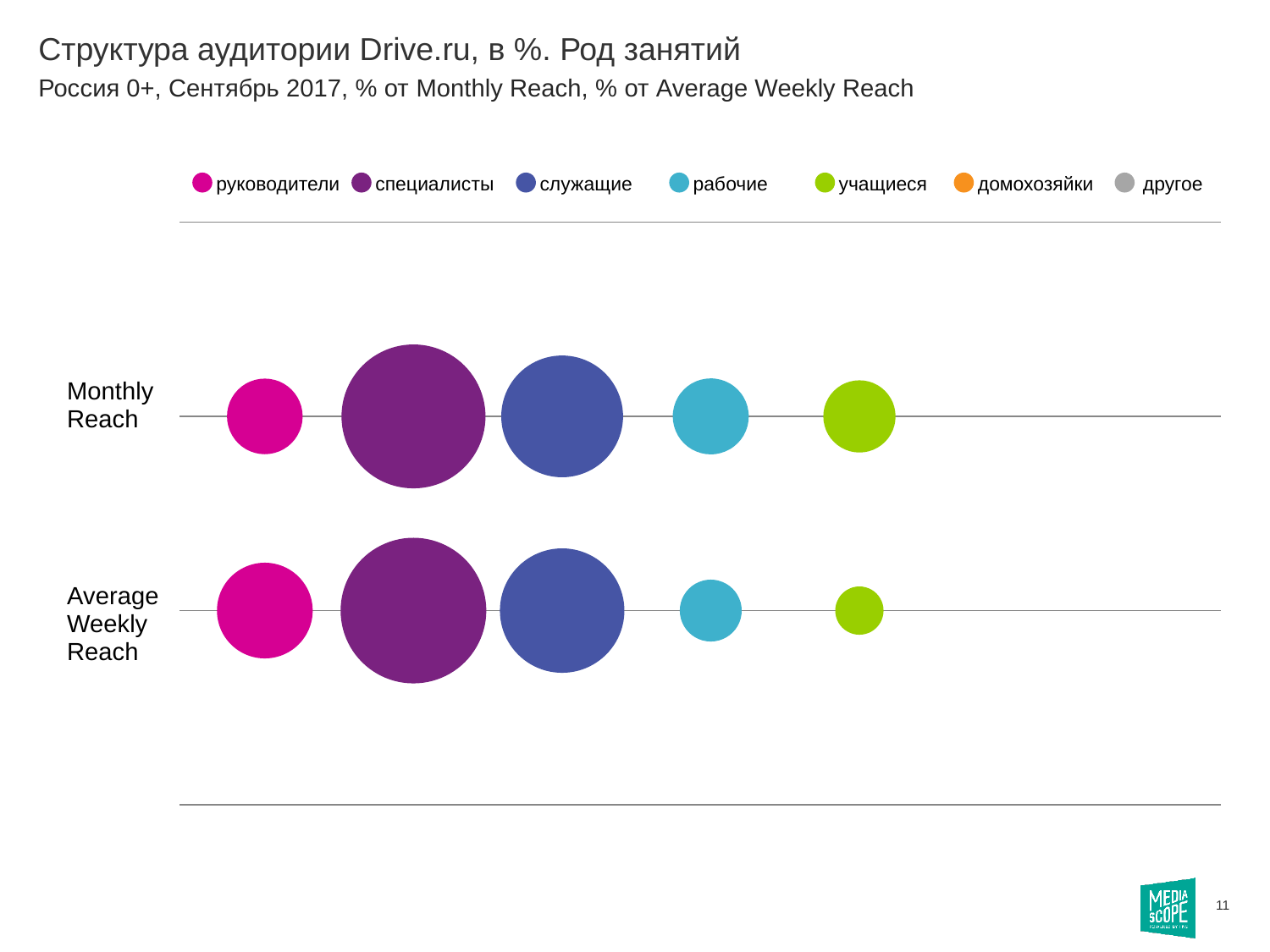
How many rows (reach measures) are plotted on the chart? 2 Which legend entry is shown in orange? домохозяйки For учащиеся, which row has the larger bubble: Monthly Reach or Average Weekly Reach? Monthly Reach In the Monthly Reach row, which bubble is larger: служащие or рабочие? служащие For руководители, which row has the larger bubble: Monthly Reach or Average Weekly Reach? Average Weekly Reach Which occupation category has the largest bubble in the Average Weekly Reach row? специалисты What is the title of the chart on the slide? Структура аудитории Drive.ru, в %. Род занятий Which occupation category has the largest bubble in the Monthly Reach row? специалисты How many categories does the legend list? 7 What kind of chart is shown on the slide? bubble chart